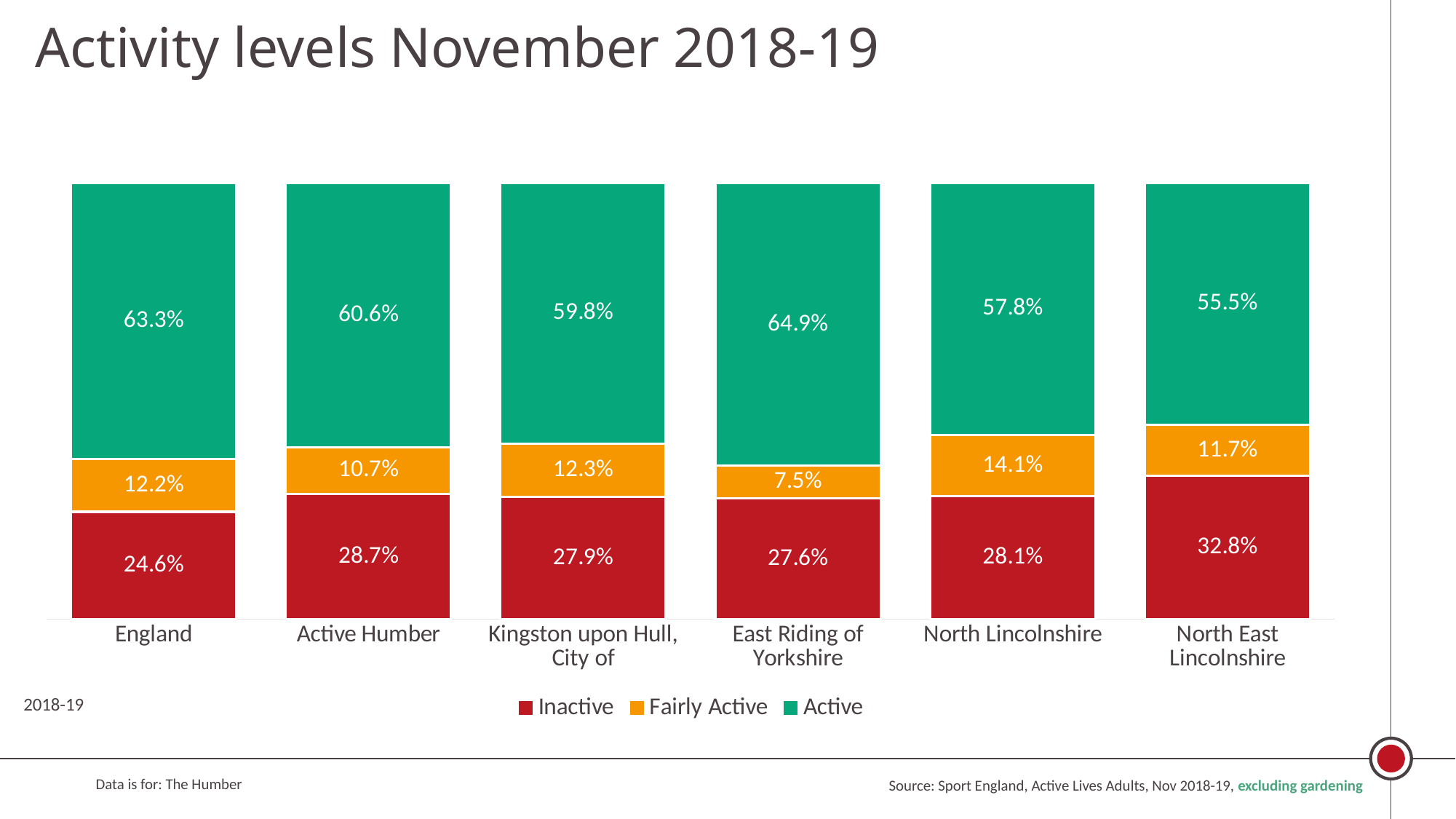
How many series does the legend list? 3 Which category has the highest Inactive percentage? North East Lincolnshire Which category has the lowest Fairly Active percentage? East Riding of Yorkshire How many categories are shown on the x axis? 6 Which has a larger Inactive percentage, Active Humber or Kingston upon Hull, City of? Active Humber What kind of chart is shown on the slide? Stacked bar chart What is the Active percentage for East Riding of Yorkshire? 64.9% Which colour represents the Inactive series in the legend? Red What is the Fairly Active percentage for Active Humber? 10.7% What is the difference between the Active percentage for England and for North East Lincolnshire? 7.8% What is the Inactive percentage for North East Lincolnshire? 32.8% Which category has the highest Active percentage? East Riding of Yorkshire